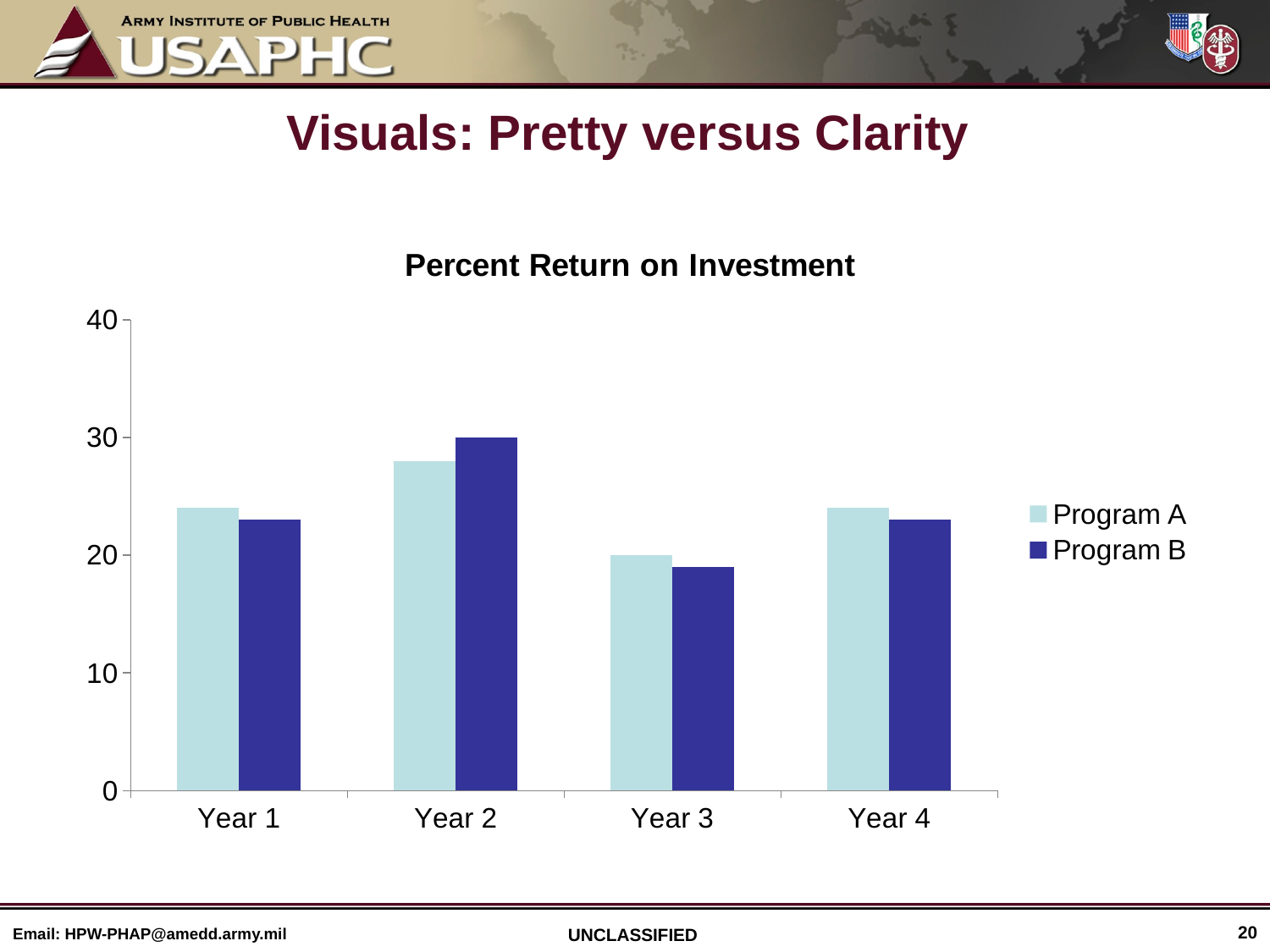
In which year is Program B highest? Year 2 What is the value for Program A in Year 3? 20 How many year categories are shown on the x axis? 4 In Year 2, which program has the larger value, Program A or Program B? Program B What is the value for Program B in Year 2? 30 Is the value for Program A in Year 1 greater or less than 20? greater How many series does the legend list? 2 Which legend entry is shown in dark blue? Program B Is the value for Program B in Year 3 greater or less than 20? less What is the title of the chart? Percent Return on Investment What kind of chart is shown on the slide? bar chart In which year is Program B lowest? Year 3